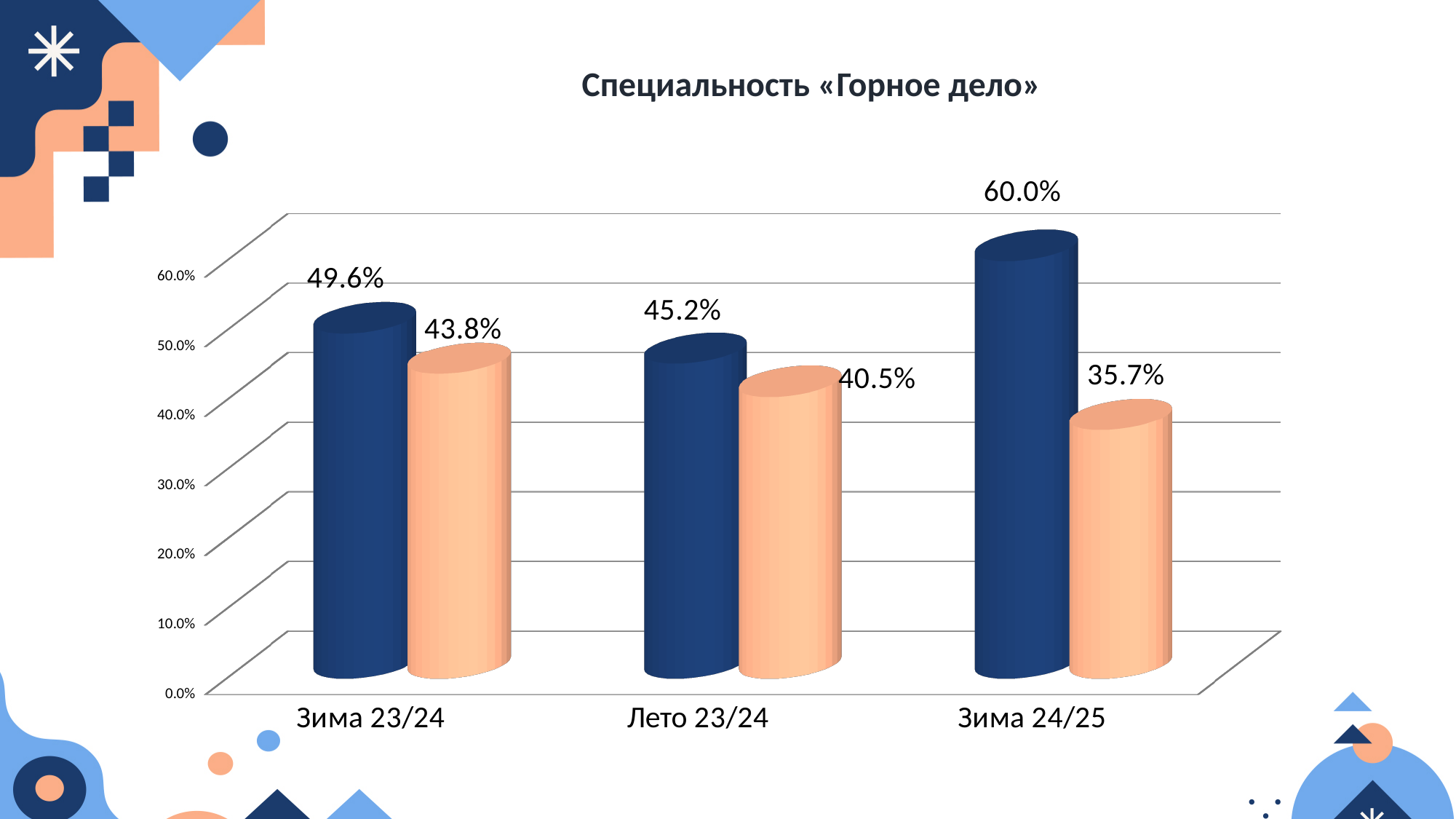
What is the difference between the dark blue and orange bars for Зима 24/25? 24.3% Which is larger for Лето 23/24: the dark blue bar or the orange bar? the dark blue bar What is the value of the orange bar for Лето 23/24? 40.5% Do the orange bars rise or fall from Зима 23/24 to Зима 24/25? fall What is the title of the chart? Специальность «Горное дело» Which category has the highest dark blue bar? Зима 24/25 What is the value of the orange bar for Зима 24/25? 35.7% What is the value of the dark blue bar for Зима 24/25? 60.0% How many categories are shown on the x axis? 3 What kind of chart is shown on the slide? bar chart What is the value of the dark blue bar for Зима 23/24? 49.6% Which category has the lowest orange bar? Зима 24/25